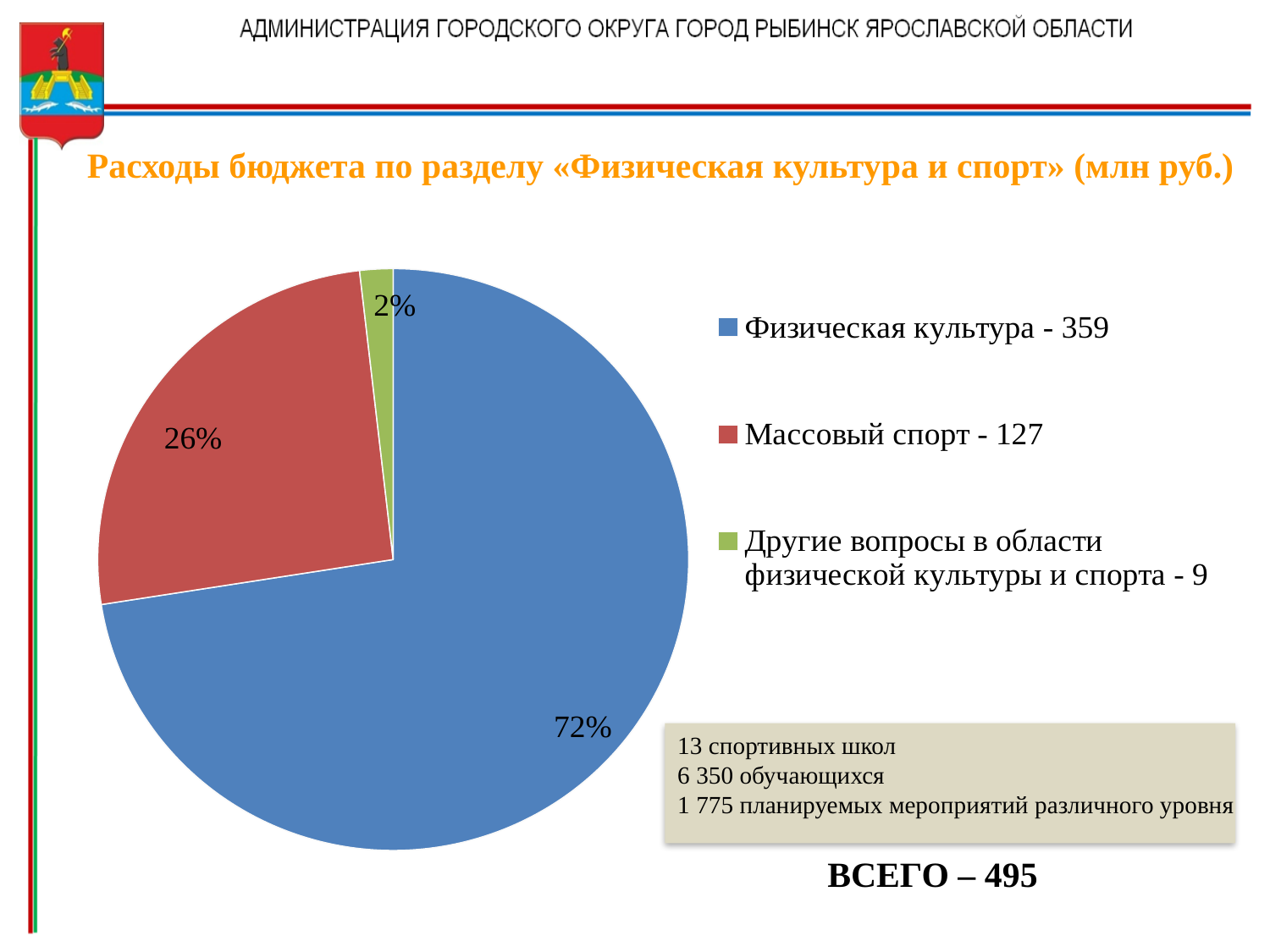
What kind of chart is shown on the slide? Pie chart What is the value (млн руб.) for «Массовый спорт» according to the legend? 127 What colour is the slice for «Массовый спорт»? Red How many slices does the pie chart have? 3 Which category has the largest slice of the pie? Физическая культура Which is larger: the value for «Массовый спорт» or for «Другие вопросы в области физической культуры и спорта»? Массовый спорт Which category has the smallest slice of the pie? Другие вопросы в области физической культуры и спорта What is the difference between the values for «Физическая культура» and «Массовый спорт»? 232 What is the value (млн руб.) for «Физическая культура» according to the legend? 359 What share of the pie does «Физическая культура» take? 72% What share of the pie does «Другие вопросы в области физической культуры и спорта» take? 2% What share of the pie does «Массовый спорт» take? 26%